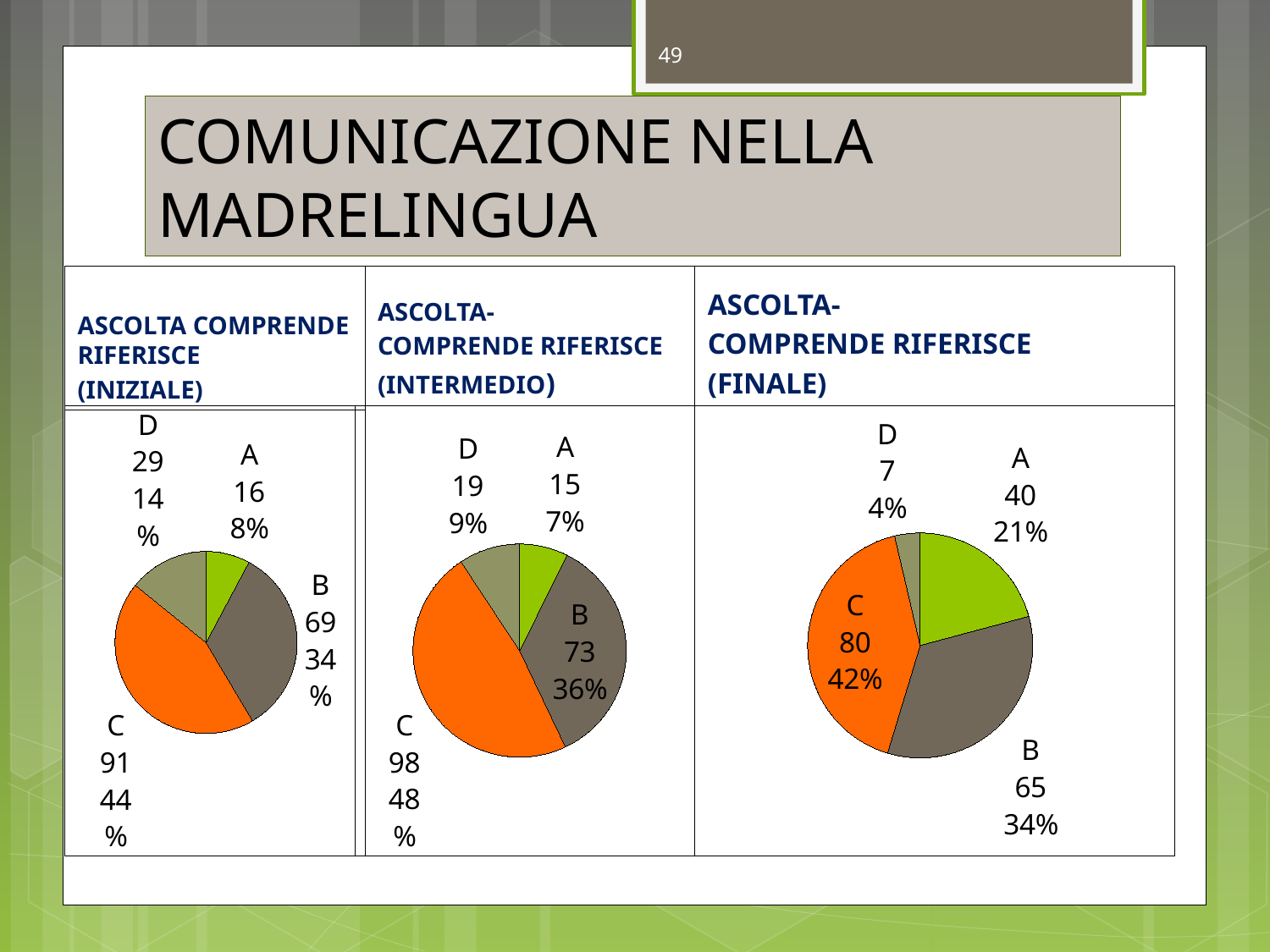
In the INIZIALE pie chart, what share of the pie does category B represent? 34% In the FINALE pie chart, what is the difference between the values for C and B? 15 In the INIZIALE pie chart, what is the value for category C? 91 How many pie charts are shown on the slide? 3 In the INTERMEDIO pie chart, which category has the largest slice? C What kind of chart is used in the INTERMEDIO panel? Pie chart In the FINALE pie chart, which category has the smallest slice? D In the INTERMEDIO pie chart, what share of the pie does category A represent? 7% In the FINALE pie chart, which is larger, the value for A or the value for D? A In the INTERMEDIO pie chart, what is the value for category D? 19 How many slices does the INIZIALE pie chart have? 4 In the FINALE pie chart, what is the value for category A? 40